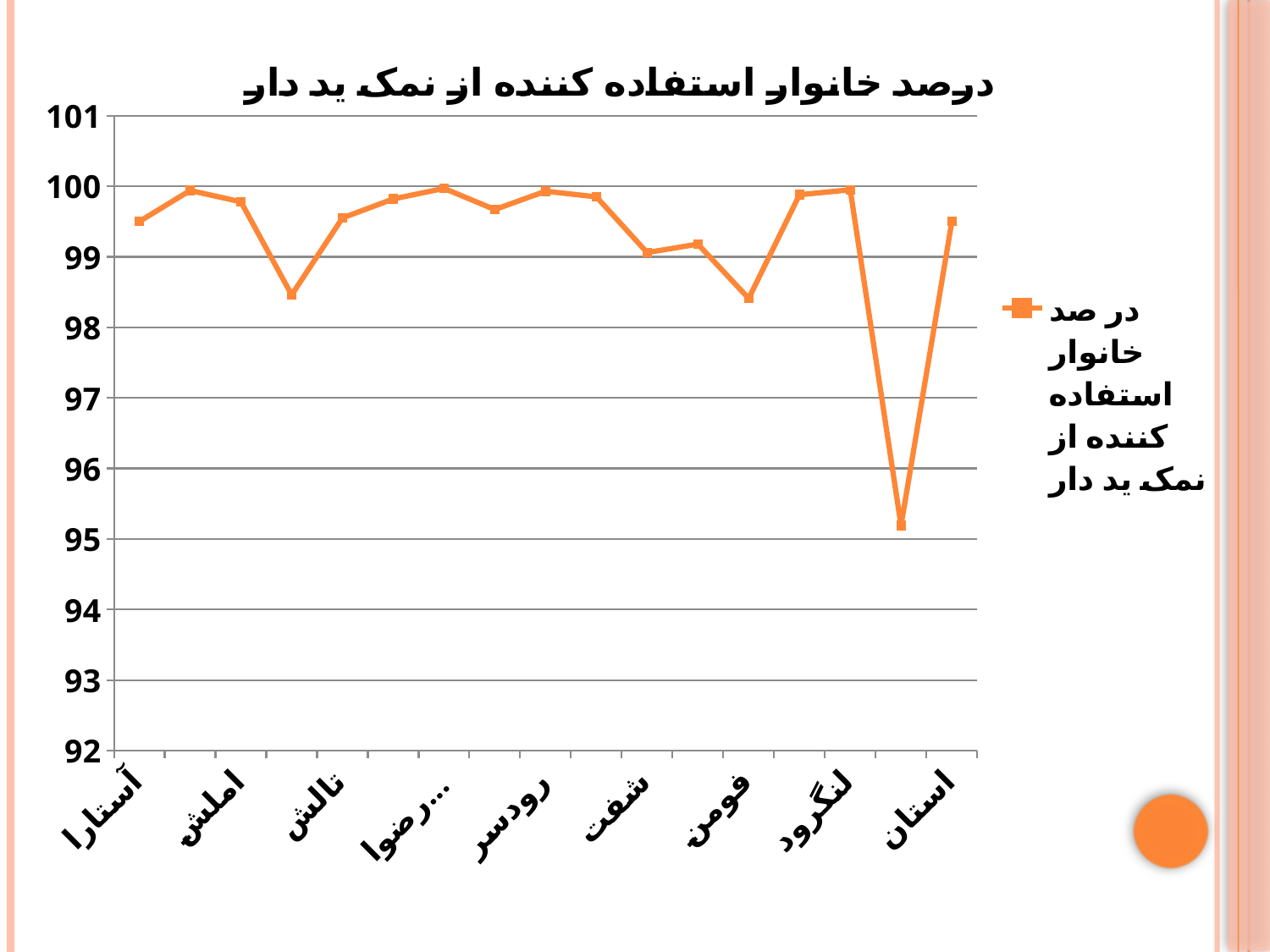
How many series does the legend list? 1 Is the value for استان greater or less than 99? greater Is the value for لنگرود greater or less than 99? greater Which has the larger value, فومن or لنگرود? لنگرود Is the lowest point on the line greater or less than 96? less What is the title of the chart? درصد خانوار استفاده کننده از نمک ید دار Which has the larger value, آستارا or فومن? آستارا What kind of chart is shown on the slide? line chart How many category labels are printed along the x axis? 9 What colour is the plotted line? orange